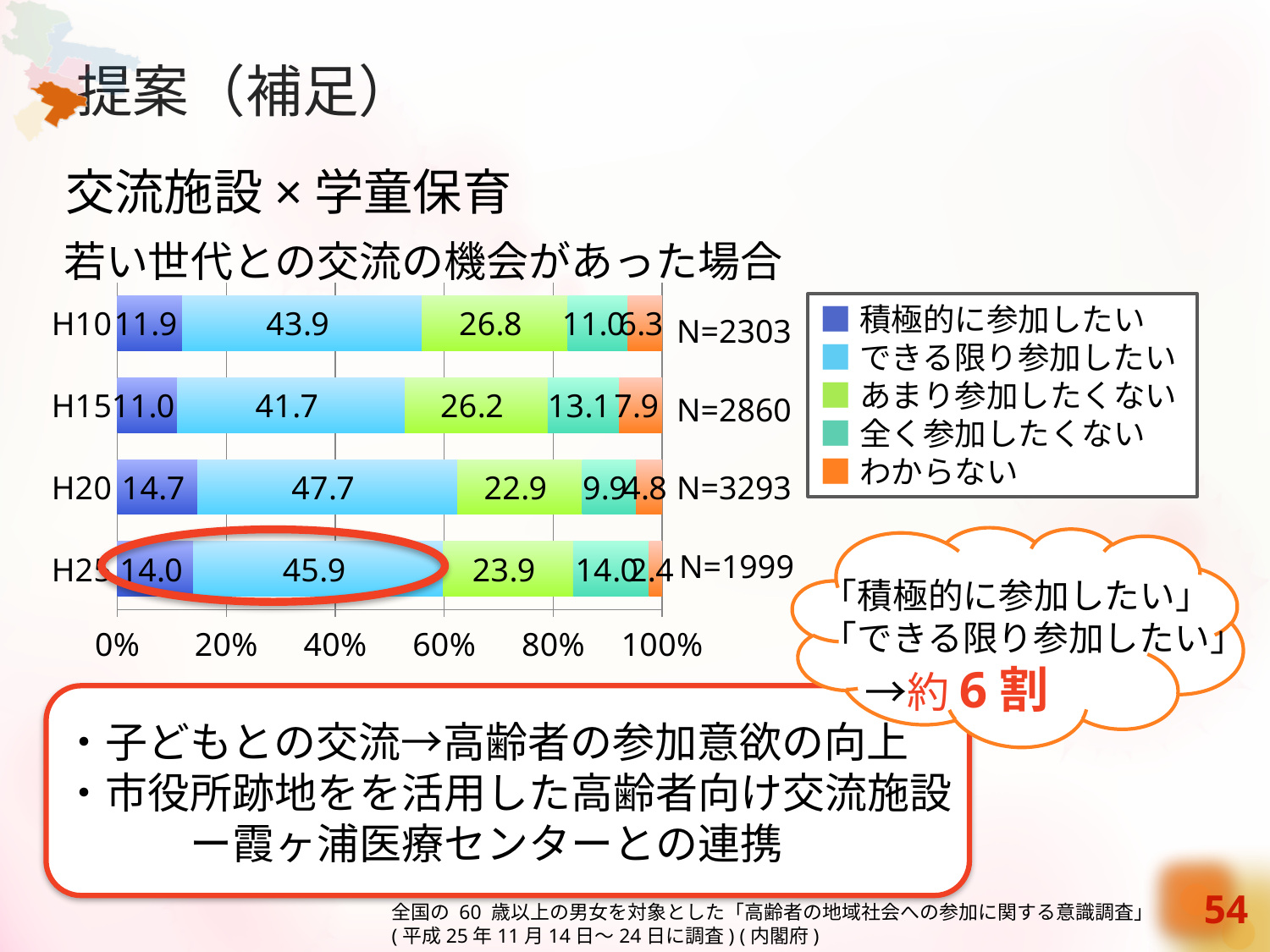
Which survey year has the lowest value for 積極的に参加したい? H15 What type of chart is shown on the slide? stacked bar chart What is the value of あまり参加したくない for H10? 26.8 Which is larger, the あまり参加したくない value for H10 or for H25? H10 What is the value of 積極的に参加したい for H25? 14.0 How many categories (survey years) are plotted on the chart? 4 What is the value of 全く参加したくない for H15? 13.1 How many series does the chart legend list? 5 Which survey year has the highest value for できる限り参加したい? H20 What is the difference between the できる限り参加したい values for H20 and H15? 6.0 What is the sample size (N) shown for H20? N=3293 What is the value of できる限り参加したい for H20? 47.7